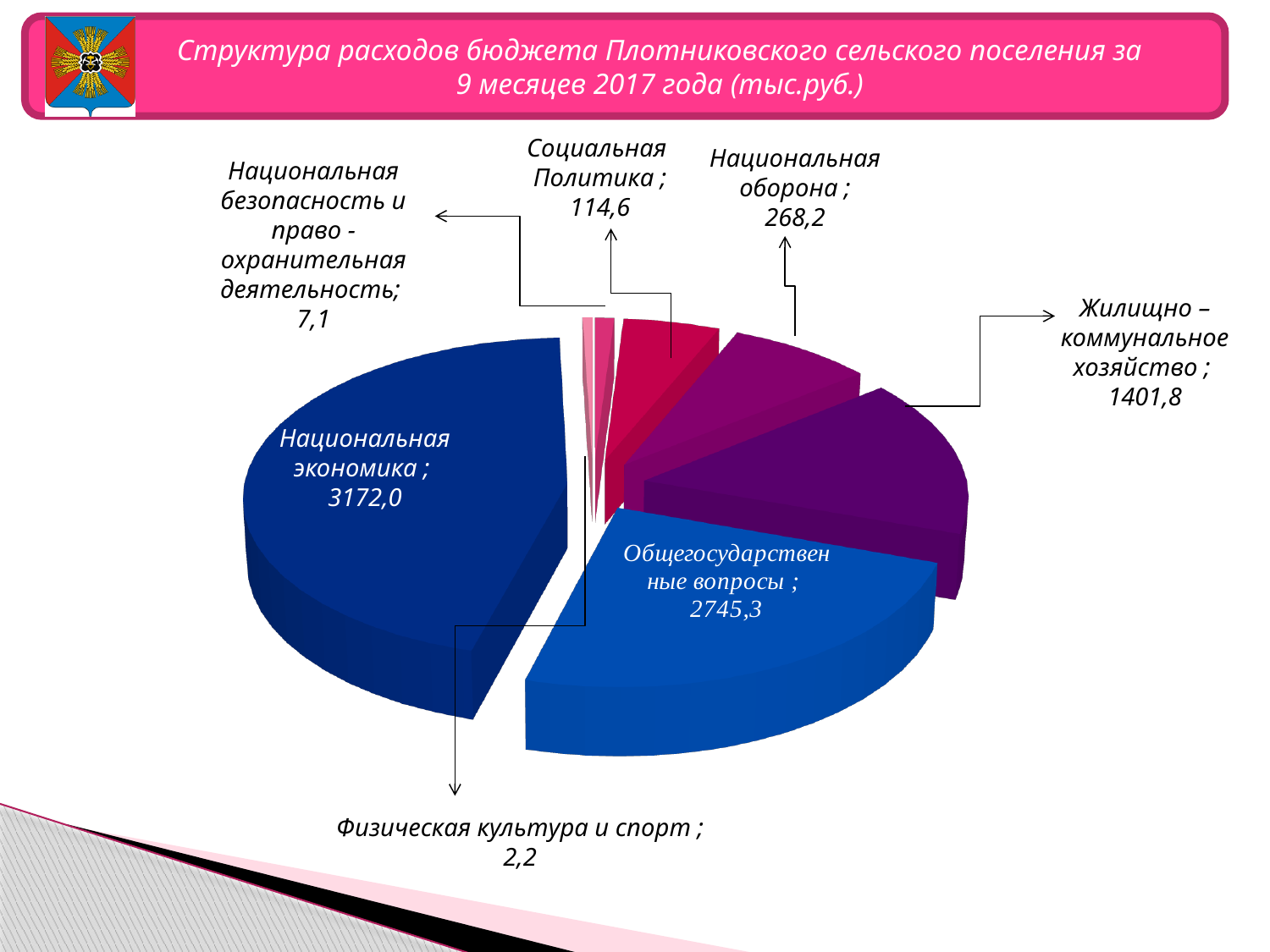
What is the difference between Национальная экономика and Общегосударственные вопросы? 426,7 What is the value for Жилищно-коммунальное хозяйство? 1401,8 What is the value for Национальная экономика? 3172,0 What is the value for Социальная политика? 114,6 Which category has the smallest value? Физическая культура и спорт What is the value for Физическая культура и спорт? 2,2 Which category has the largest value? Национальная экономика What is the title of the chart on the slide? Структура расходов бюджета Плотниковского сельского поселения за 9 месяцев 2017 года (тыс.руб.) What is the value for Общегосударственные вопросы? 2745,3 How many categories (slices) does the pie chart show? 7 Which is larger: Национальная оборона or Социальная политика? Национальная оборона What kind of chart is shown on the slide? Pie chart